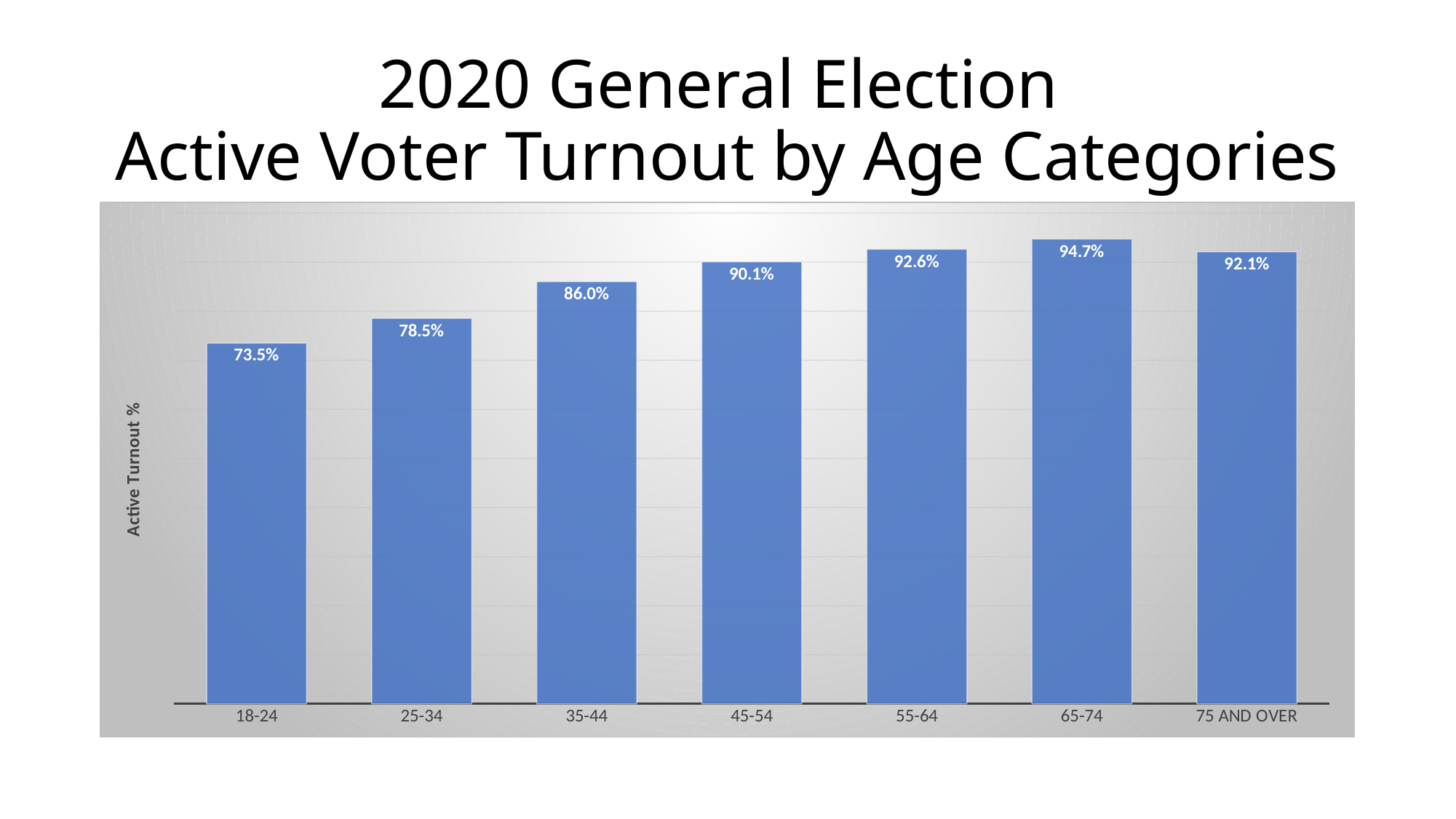
What is the label on the vertical axis of the chart? Active Turnout % Which age category has the lowest active turnout? 18-24 What is the difference in active turnout between the 65-74 and 18-24 age categories? 21.2% What is the active turnout for the 18-24 age category? 73.5% What is the active turnout for the 35-44 age category? 86.0% What is the active turnout for the 65-74 age category? 94.7% What kind of chart is shown on the slide? Bar chart How many age categories are shown in the chart? 7 What is the difference in active turnout between the 25-34 and 35-44 age categories? 7.5% What is the active turnout for the 75 AND OVER age category? 92.1% Which has a higher active turnout, 45-54 or 75 AND OVER? 75 AND OVER Which age category has the highest active turnout? 65-74